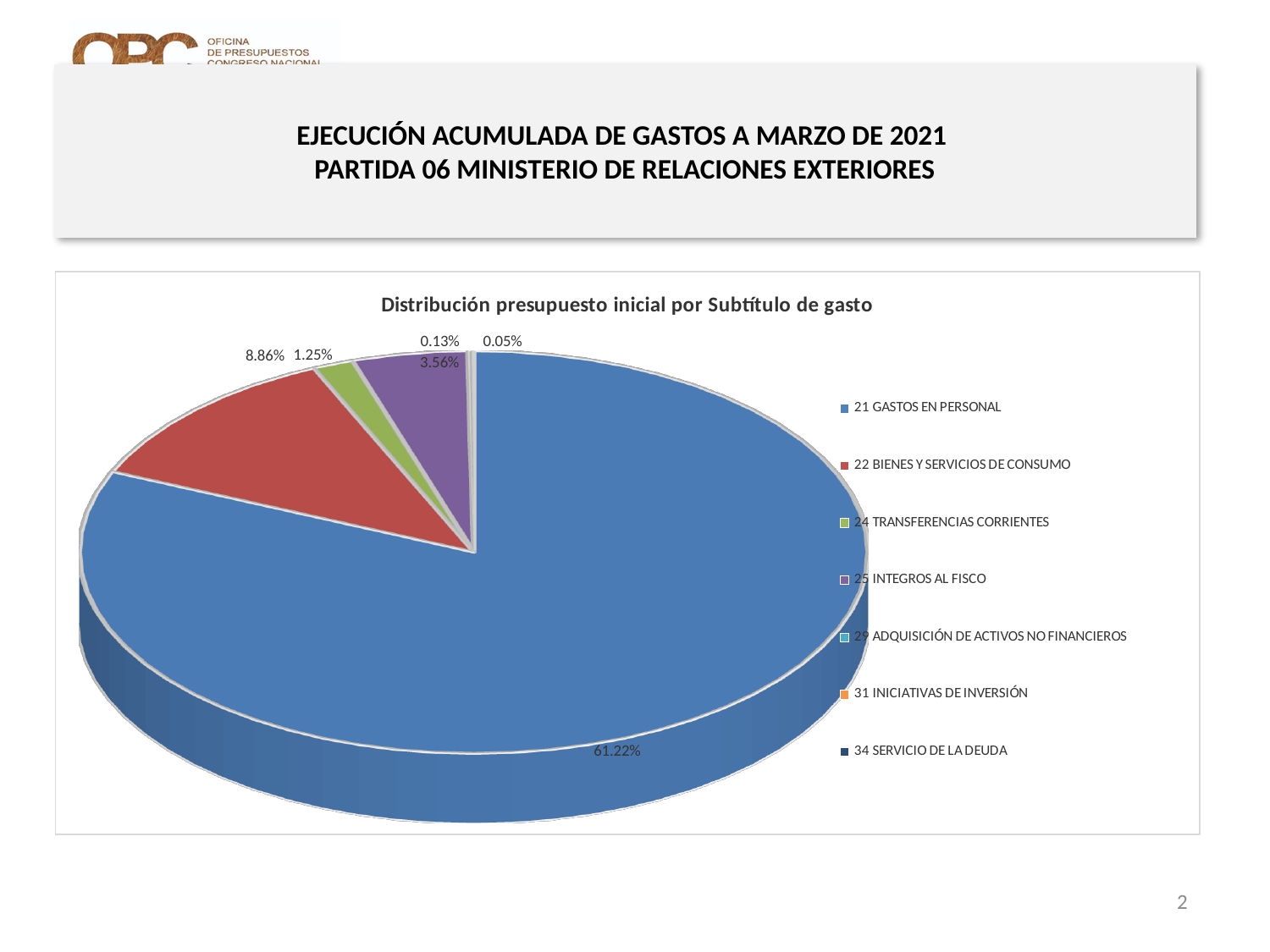
What percentage share does 25 INTEGROS AL FISCO have in the pie chart? 3.56% What is the title of the chart? Distribución presupuesto inicial por Subtítulo de gasto What percentage share does 22 BIENES Y SERVICIOS DE CONSUMO have in the pie chart? 8.86% What is the difference in percentage points between the shares of 21 GASTOS EN PERSONAL and 22 BIENES Y SERVICIOS DE CONSUMO? 52.36% Which category has the largest slice of the pie chart? 21 GASTOS EN PERSONAL How many categories are listed in the chart's legend? 7 What is the difference in percentage points between the shares of 22 BIENES Y SERVICIOS DE CONSUMO and 25 INTEGROS AL FISCO? 5.30% Which has a larger share: 22 BIENES Y SERVICIOS DE CONSUMO or 25 INTEGROS AL FISCO? 22 BIENES Y SERVICIOS DE CONSUMO What percentage share does 21 GASTOS EN PERSONAL have in the pie chart? 61.22% Which has a larger share: 24 TRANSFERENCIAS CORRIENTES or 25 INTEGROS AL FISCO? 25 INTEGROS AL FISCO What type of chart is shown on the slide? pie chart What percentage share does 24 TRANSFERENCIAS CORRIENTES have in the pie chart? 1.25%